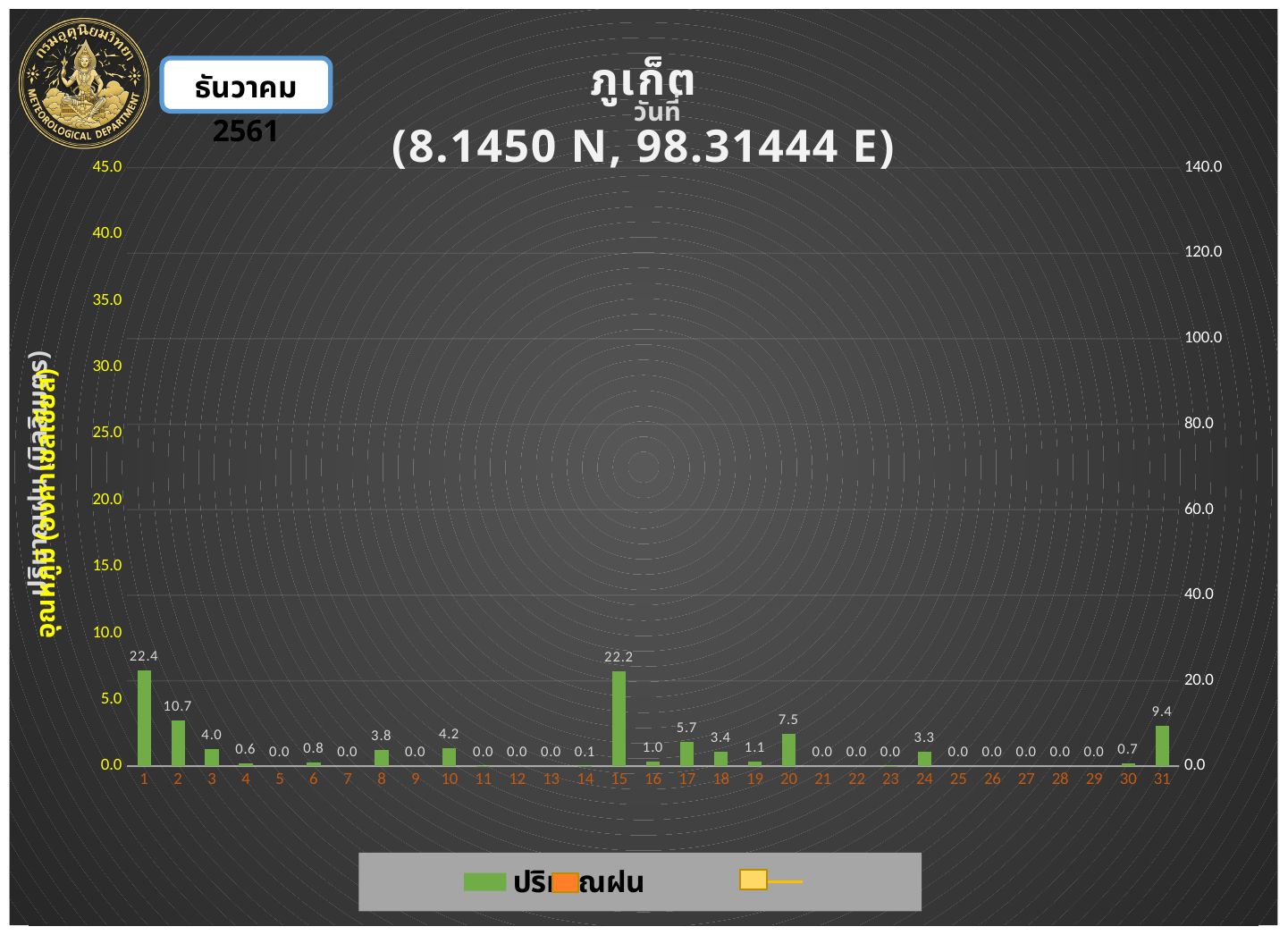
What is the value shown for day 15? 22.2 Is the value for day 1 greater or less than 20.0 on the right-hand axis? greater What is the difference between the values for day 1 and day 2? 11.7 Which has a larger value, day 2 or day 31? day 2 What location name is given in the chart title? ภูเก็ต What is the rainfall value shown for day 1? 22.4 What kind of chart is shown on the slide? bar chart What is the value shown for day 20? 7.5 What is the value shown for day 31? 9.4 Which has a larger value, day 17 or day 18? day 17 How many days (categories) are shown on the x axis? 31 What is the value shown for day 14? 0.1